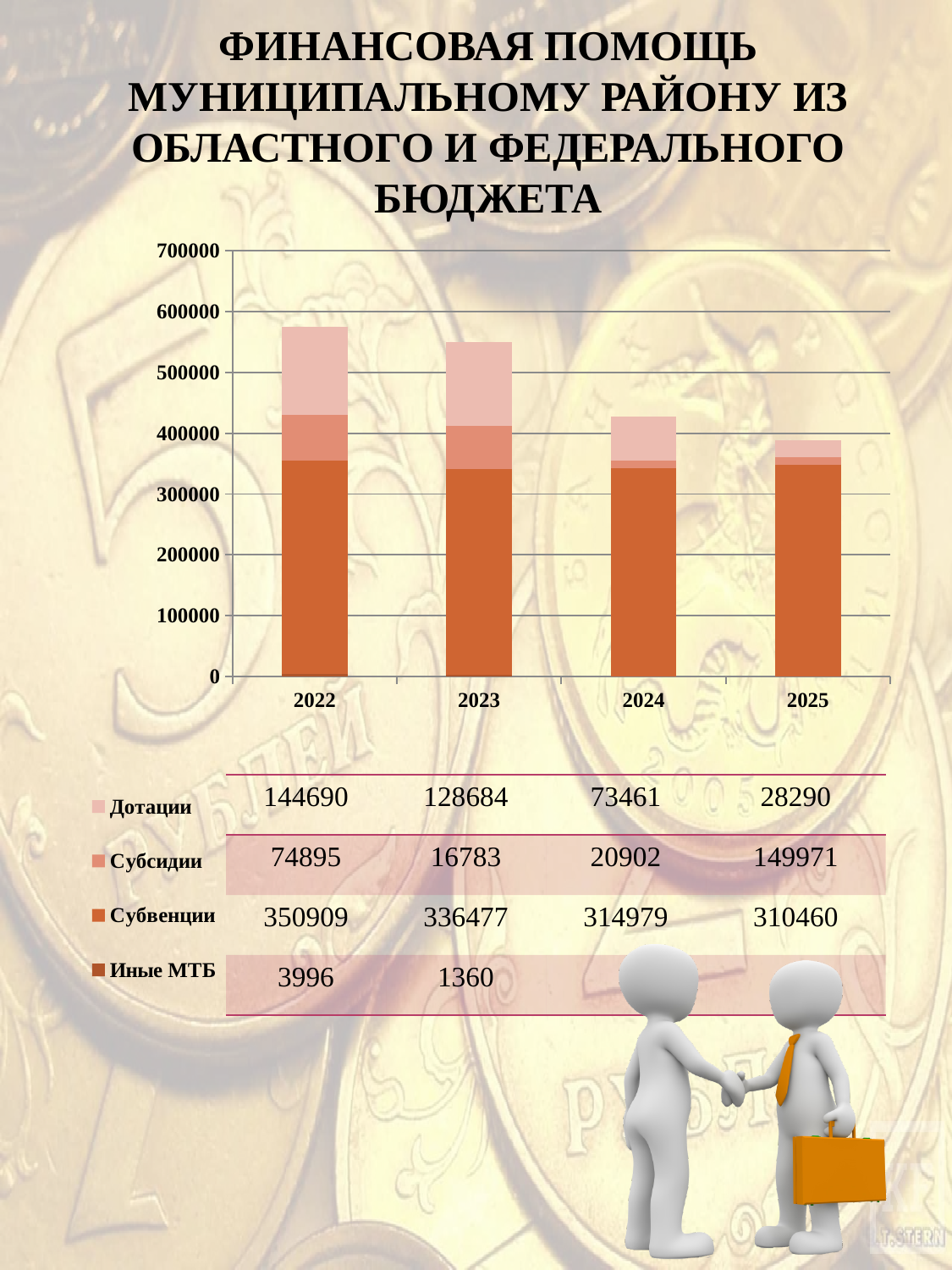
How many series does the legend of the chart list? 4 Which year has the highest value of Субвенции? 2022 Which is larger: Дотации in 2022 or Дотации in 2023? Дотации in 2022 What is the value of Субвенции for 2024? 314979 What is the value of Дотации for 2022? 144690 What kind of chart is shown on the slide? Stacked bar chart What is the value of Субсидии for 2023? 16783 Do the total heights of the stacked bars rise or fall from 2022 to 2025? Fall Which year has the lowest value of Дотации? 2025 How many years (categories) are shown on the x axis of the chart? 4 What is the difference between the Субвенции values for 2022 and 2025? 40449 What is the value of Иные МТБ for 2022? 3996